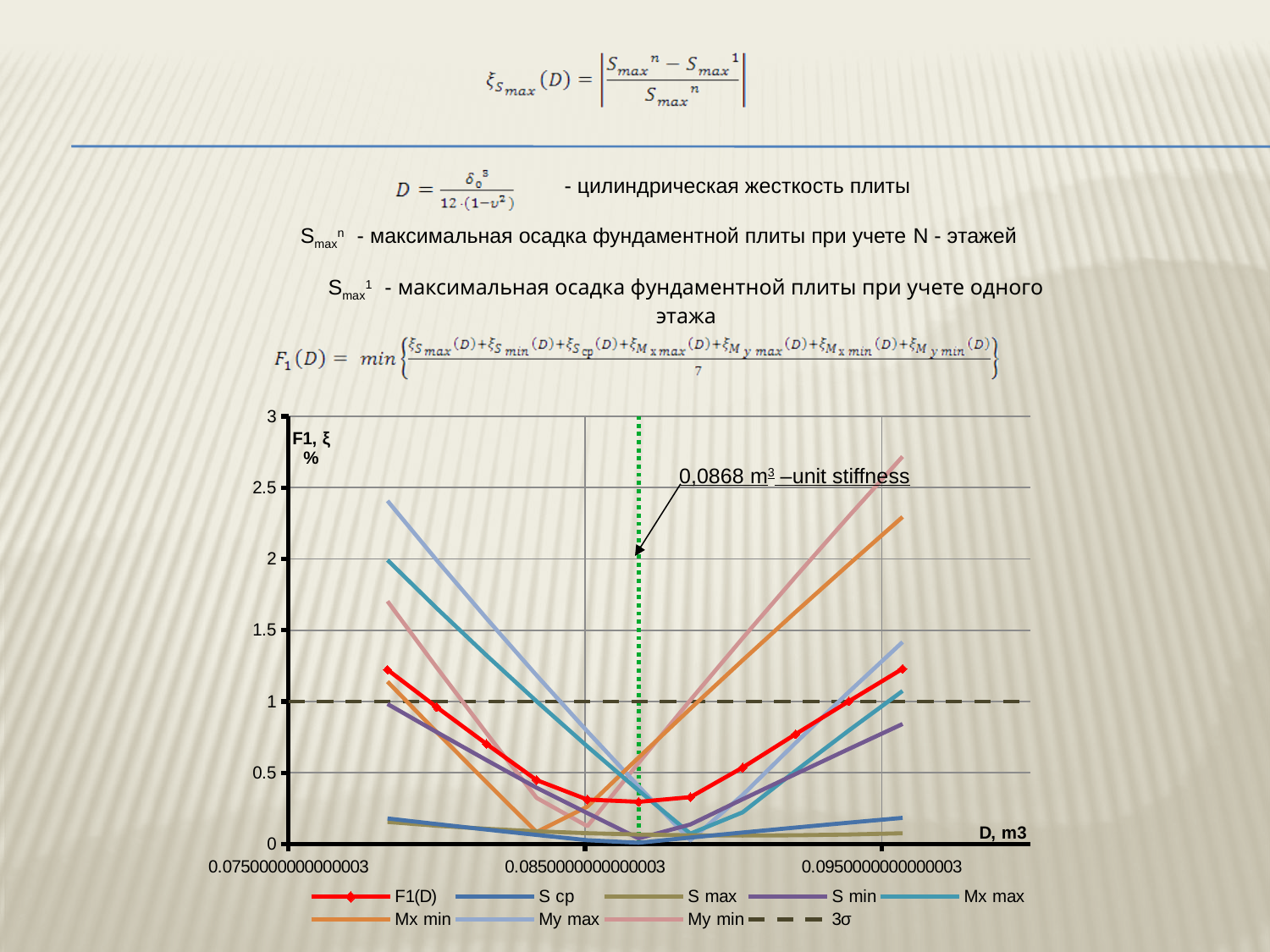
At the right end of the chart, which is larger: My min or S max? My min What value of D does the annotation label as the unit stiffness? 0,0868 m3 Is the value of F1(D) at its leftmost point greater or less than 1? greater What is the label of the horizontal axis? D, m3 Does the F1(D) curve rise or fall as D increases from the left edge toward the green dotted line? fall At what value on the vertical axis is the dashed 3σ line drawn? 1 How many series does the chart legend list? 9 Which series reaches the highest value at the right end of the chart? My min Is the lowest value of the F1(D) curve greater or less than 0.5? less What kind of chart is shown on the slide? line chart Is the value of My min at the right end of the chart greater or less than 2.5? greater